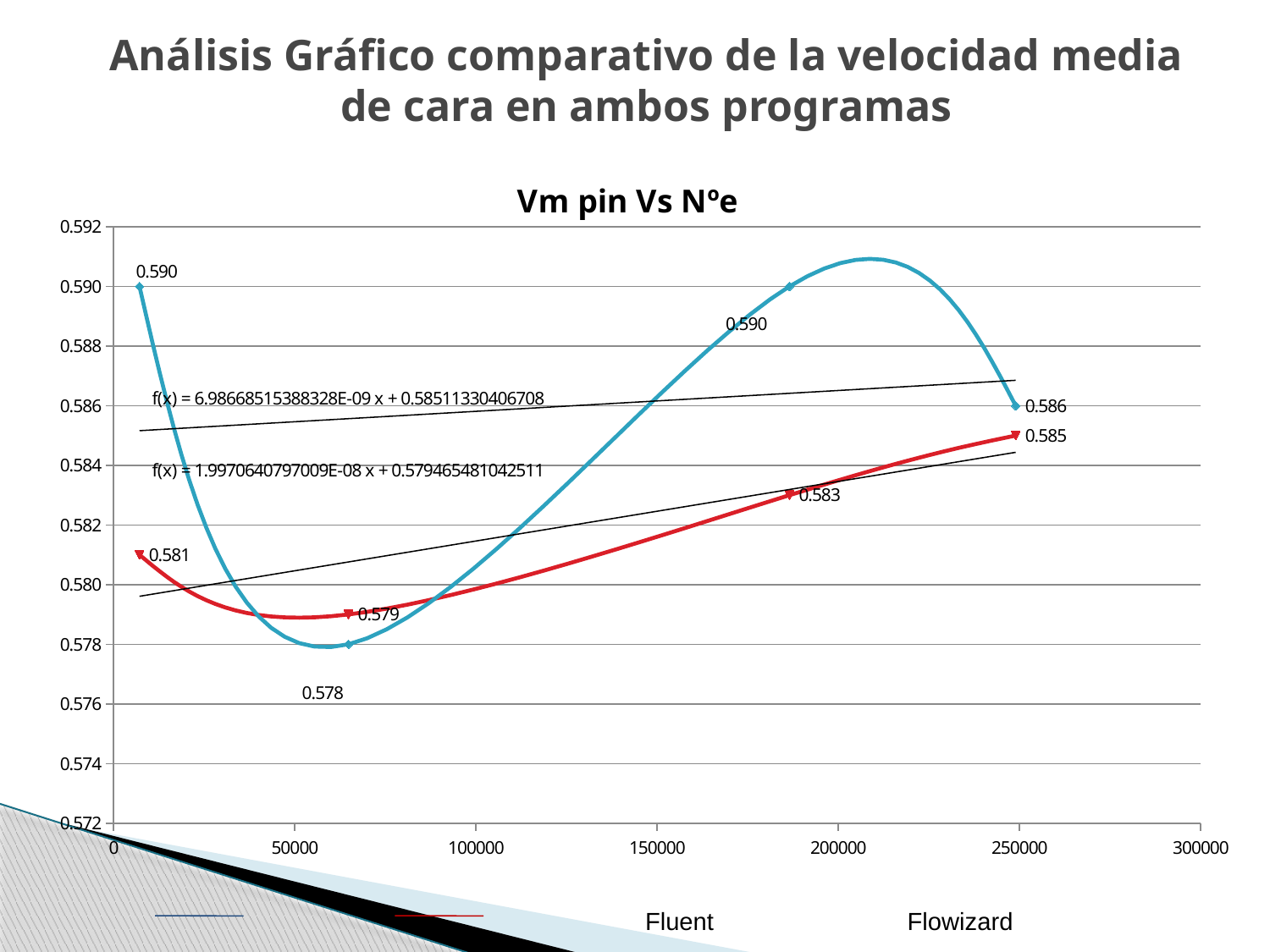
What is the value of the first (leftmost) Fluent data point? 0.590 At the rightmost data point (around 250000), which series has the larger value, Fluent or Flowizard? Fluent What is the highest value in the Flowizard series? 0.585 What is the difference between the first Fluent value (0.590) and the first Flowizard value (0.581)? 0.009 What is the title of the chart? Vm pin Vs Nºe What is the value of the first (leftmost) Flowizard data point? 0.581 What is the lowest value in the Fluent series? 0.578 What kind of chart is shown on the slide? line chart Do the Flowizard values rise or fall from the second data point to the last data point? rise How many series does the legend list? 2 What is the lowest value in the Flowizard series? 0.579 How many data points does the Fluent series have? 4